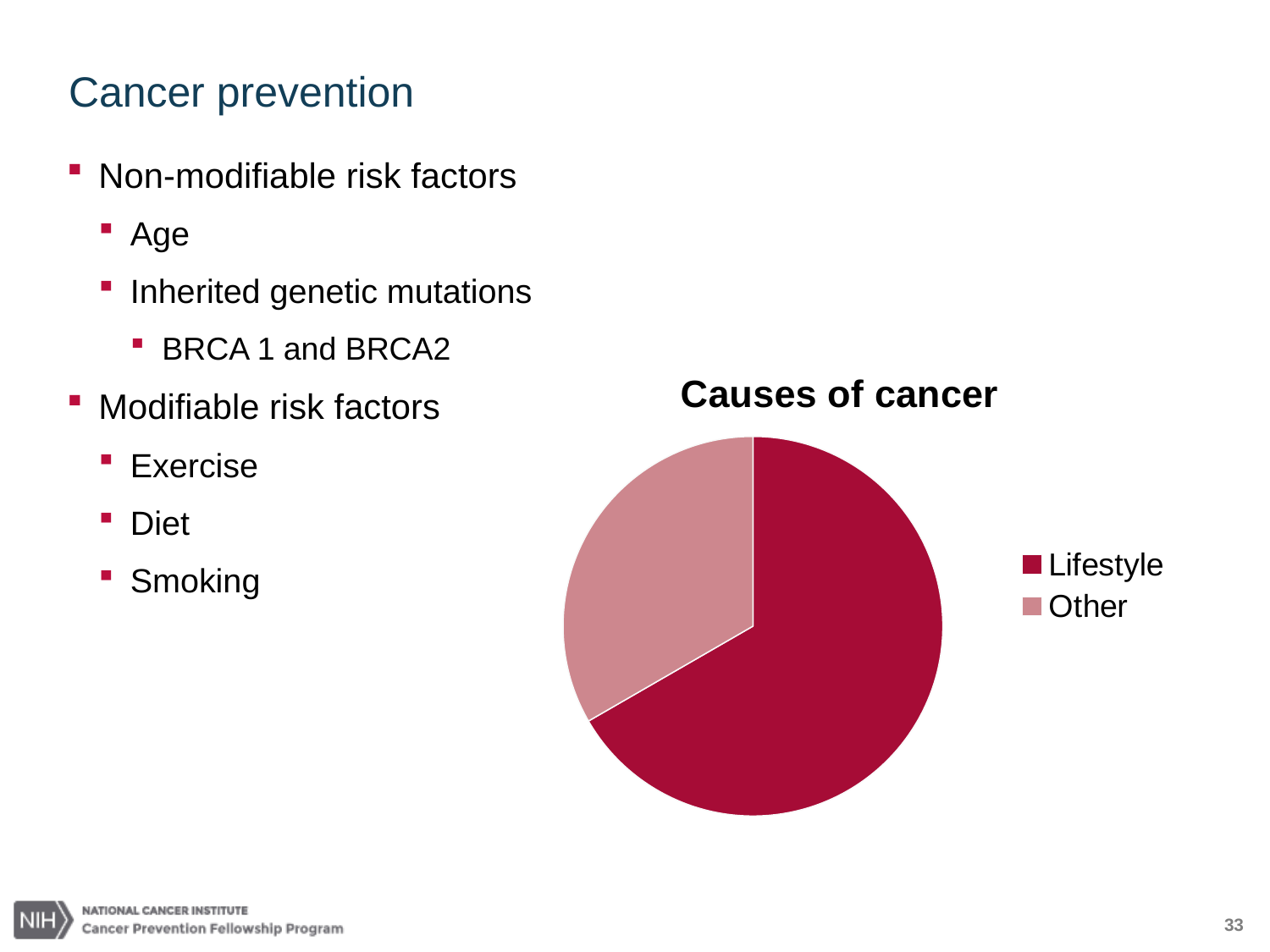
How many entries does the legend list? 2 Which slice of the pie is the smallest? Other How many slices does the pie chart have? 2 What is the title of the chart? Causes of cancer Which is larger, the Lifestyle slice or the Other slice? Lifestyle Which legend entry is shown in the darker red colour? Lifestyle What kind of chart is shown on the slide? pie chart Which slice of the pie is the largest? Lifestyle